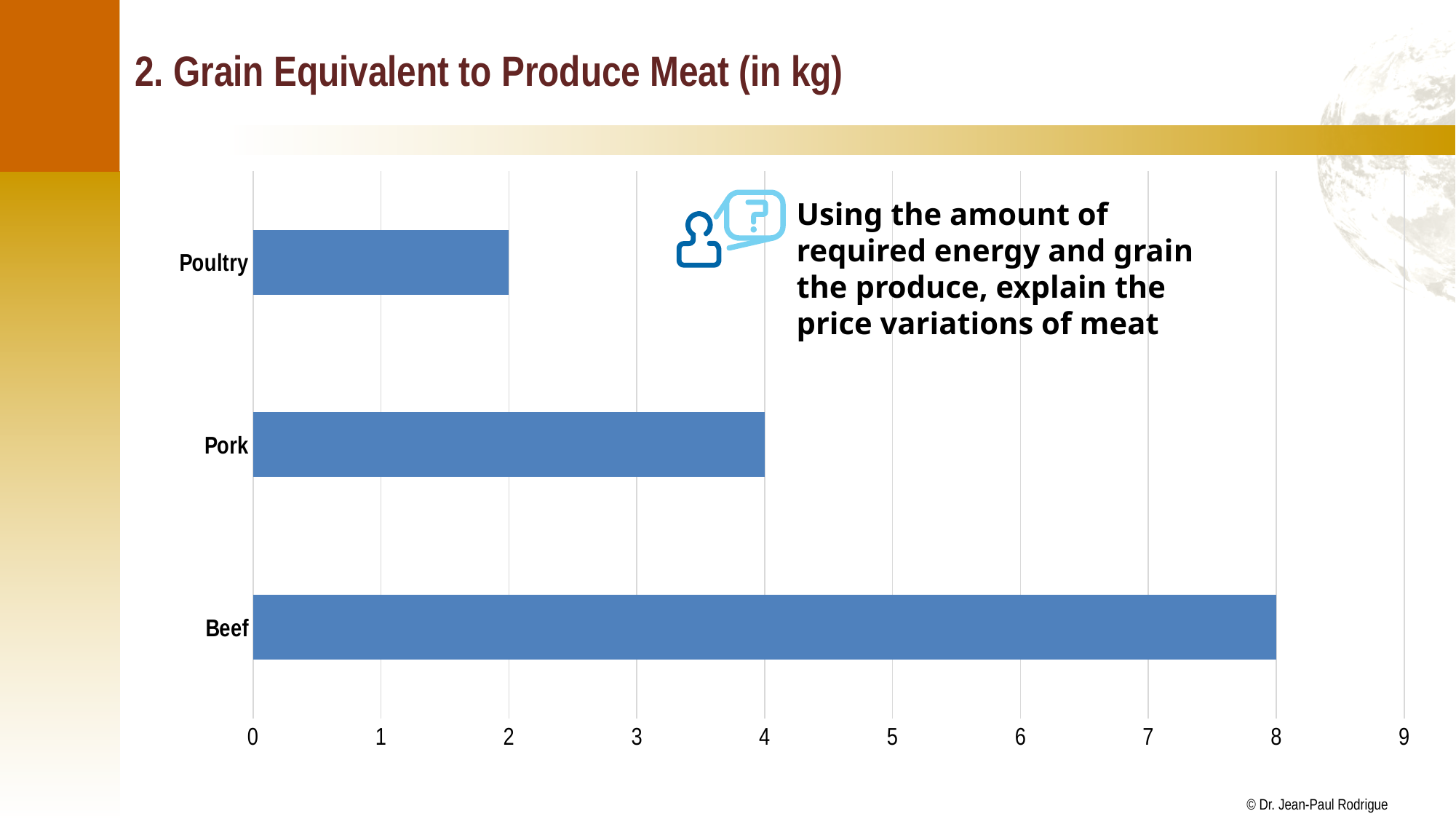
What kind of chart is shown on the slide? Bar chart Is the value for Beef greater or less than 5? greater What is the title of the slide containing the chart? 2. Grain Equivalent to Produce Meat (in kg) Which meat requires the highest grain equivalent? Beef What is the grain equivalent value for Poultry? 2 What is the grain equivalent value for Beef? 8 Which meat requires the lowest grain equivalent? Poultry What is the grain equivalent value for Pork? 4 How many meat categories are shown in the chart? 3 What is the difference between the values for Pork and Poultry? 2 Which has a larger grain equivalent, Pork or Poultry? Pork What is the difference between the values for Beef and Pork? 4